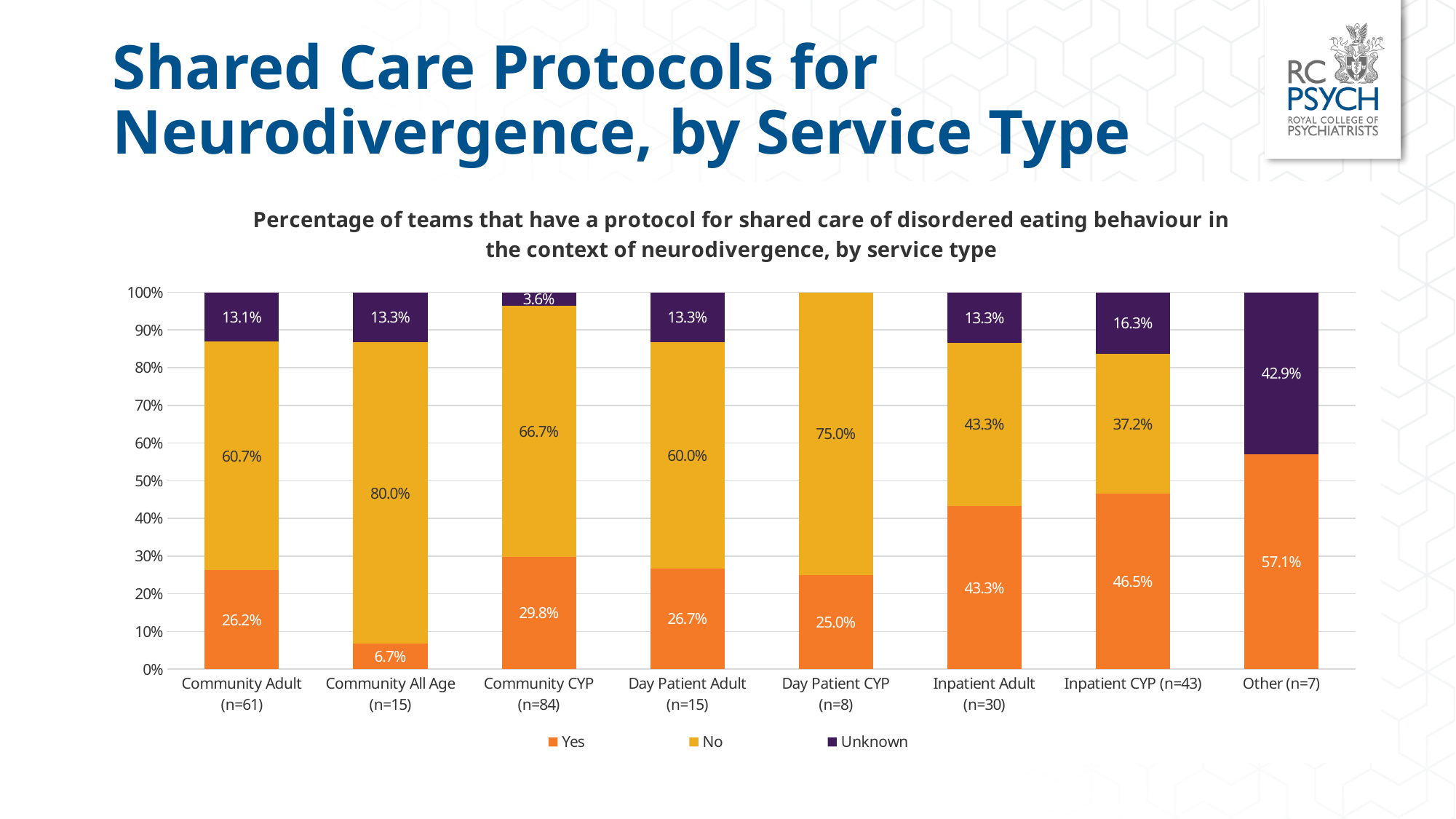
What is the Unknown value for Other (n=7)? 42.9% How many series does the legend list? 3 What is the No value for Community All Age (n=15)? 80.0% What percentage of Community Adult (n=61) teams answered Yes? 26.2% Which service type has the lowest Yes percentage? Community All Age (n=15) Which is larger, the Yes value for Inpatient Adult (n=30) or the Yes value for Community CYP (n=84)? Inpatient Adult (n=30) Which colour represents the Unknown series in the chart? Dark purple What kind of chart is shown on the slide? Stacked bar chart Which service type has the highest Yes percentage? Other (n=7) What is the Yes value for Inpatient CYP (n=43)? 46.5% What is the difference between the No values for Community All Age (n=15) and Day Patient Adult (n=15)? 20.0% How many service type categories are shown on the x axis? 8